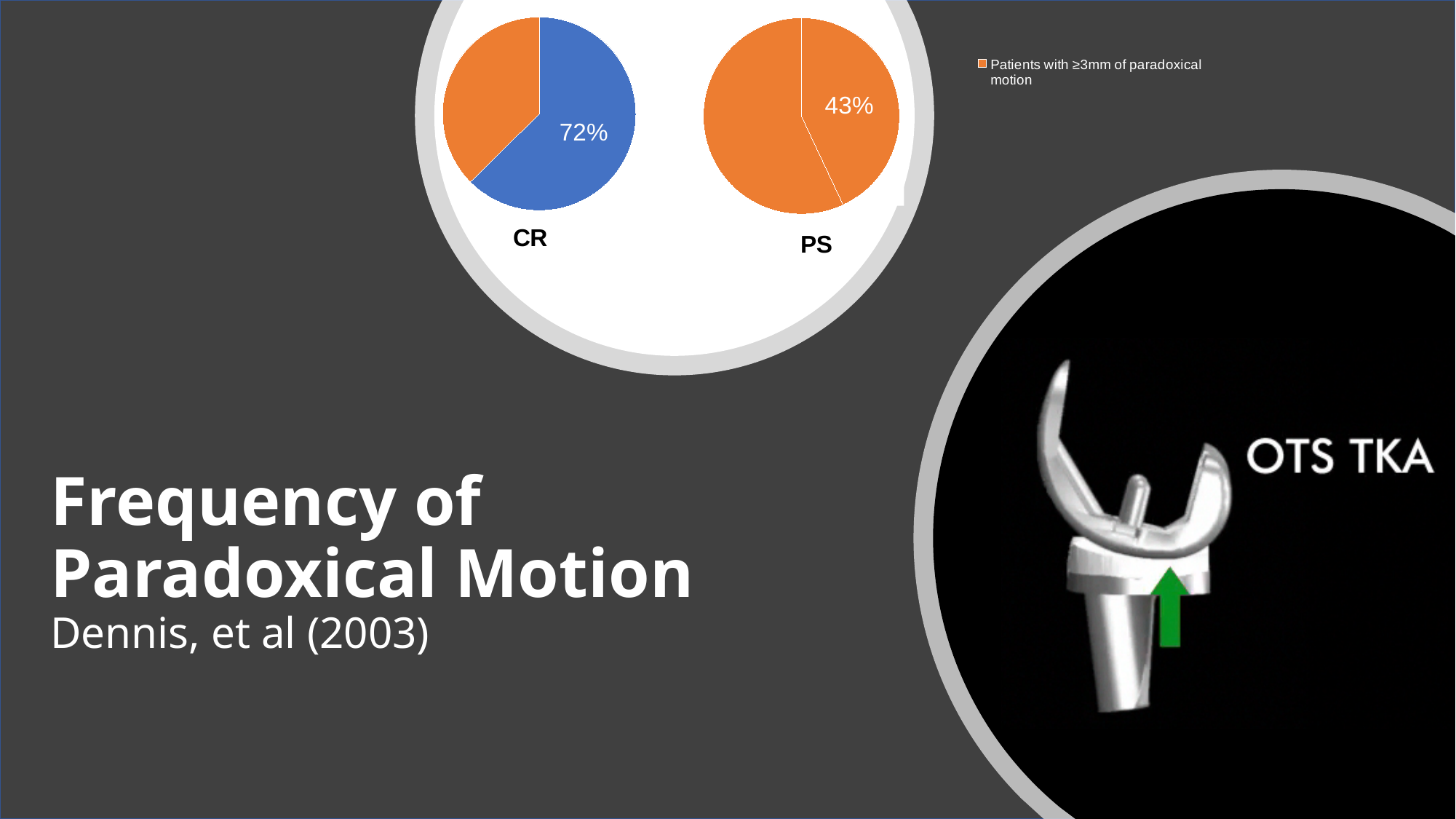
What does the legend entry next to the orange marker say? Patients with ≥3mm of paradoxical motion What is the difference between the percentage printed on the CR pie chart and the percentage printed on the PS pie chart? 29 percentage points In the PS pie chart, what percentage is printed on the chart? 43% What colour is the slice labeled 72% in the CR pie chart? Blue Which pie chart has the larger printed percentage, CR or PS? CR What kind of charts are shown at the top of the slide? Pie charts How many slices does the PS pie chart have? 2 In the CR pie chart, what percentage is printed on the blue slice? 72% How many pie charts are on the slide? 2